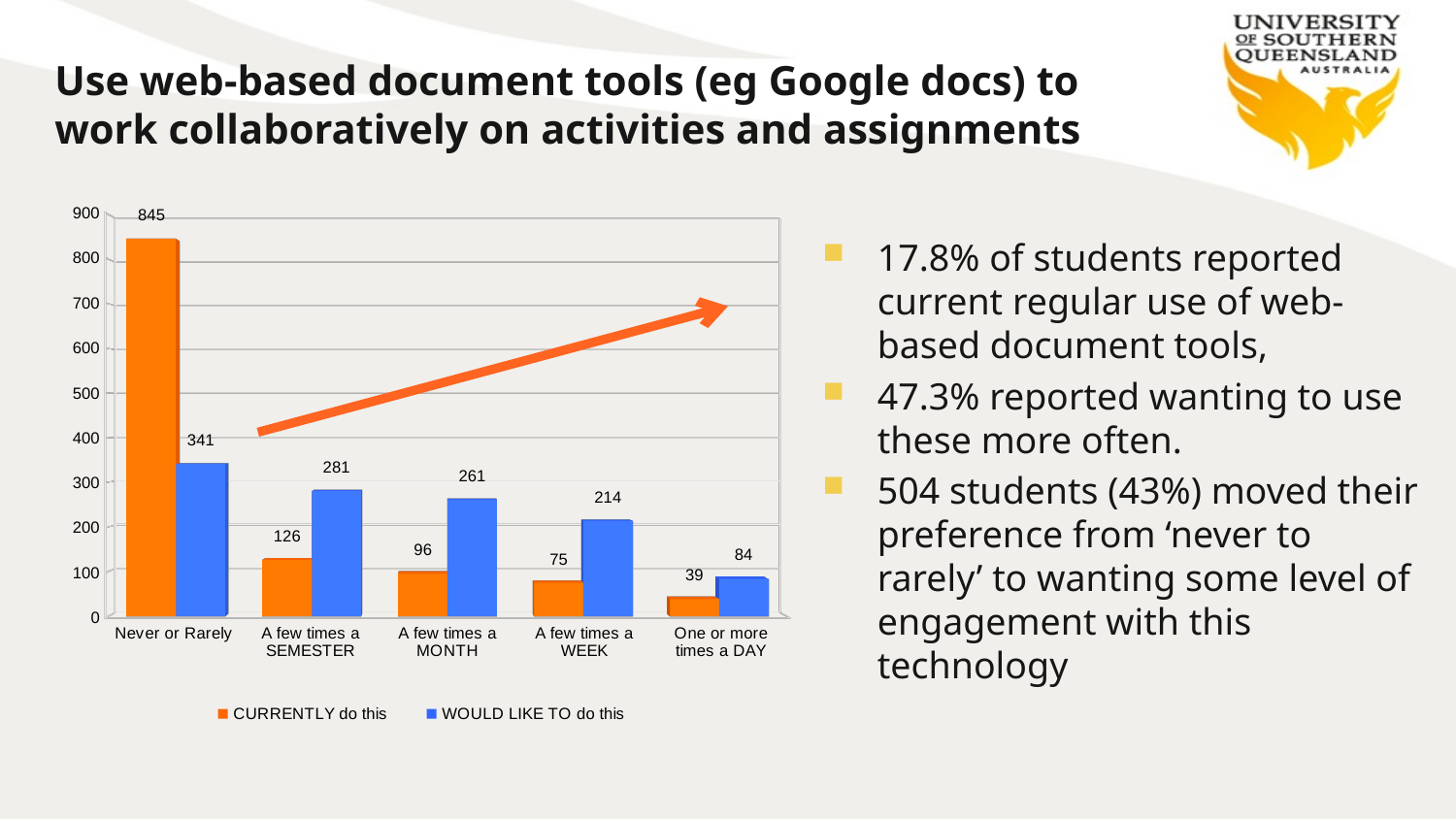
Do the values for 'CURRENTLY do this' rise or fall from 'Never or Rarely' to 'One or more times a DAY'? Fall What is the difference between 'CURRENTLY do this' and 'WOULD LIKE TO do this' in the 'Never or Rarely' category? 504 How many categories are shown on the x axis? 5 What is the value for 'WOULD LIKE TO do this' in the 'A few times a MONTH' category? 261 What is the value for 'CURRENTLY do this' in the 'One or more times a DAY' category? 39 In the 'A few times a SEMESTER' category, which series has the larger value, 'CURRENTLY do this' or 'WOULD LIKE TO do this'? WOULD LIKE TO do this Which category has the lowest value for 'CURRENTLY do this'? One or more times a DAY Which category has the highest value for 'WOULD LIKE TO do this'? Never or Rarely How many series does the legend list? 2 What kind of chart is shown on the slide? Bar chart What is the value for 'CURRENTLY do this' in the 'Never or Rarely' category? 845 What is the difference between 'WOULD LIKE TO do this' and 'CURRENTLY do this' in the 'A few times a WEEK' category? 139